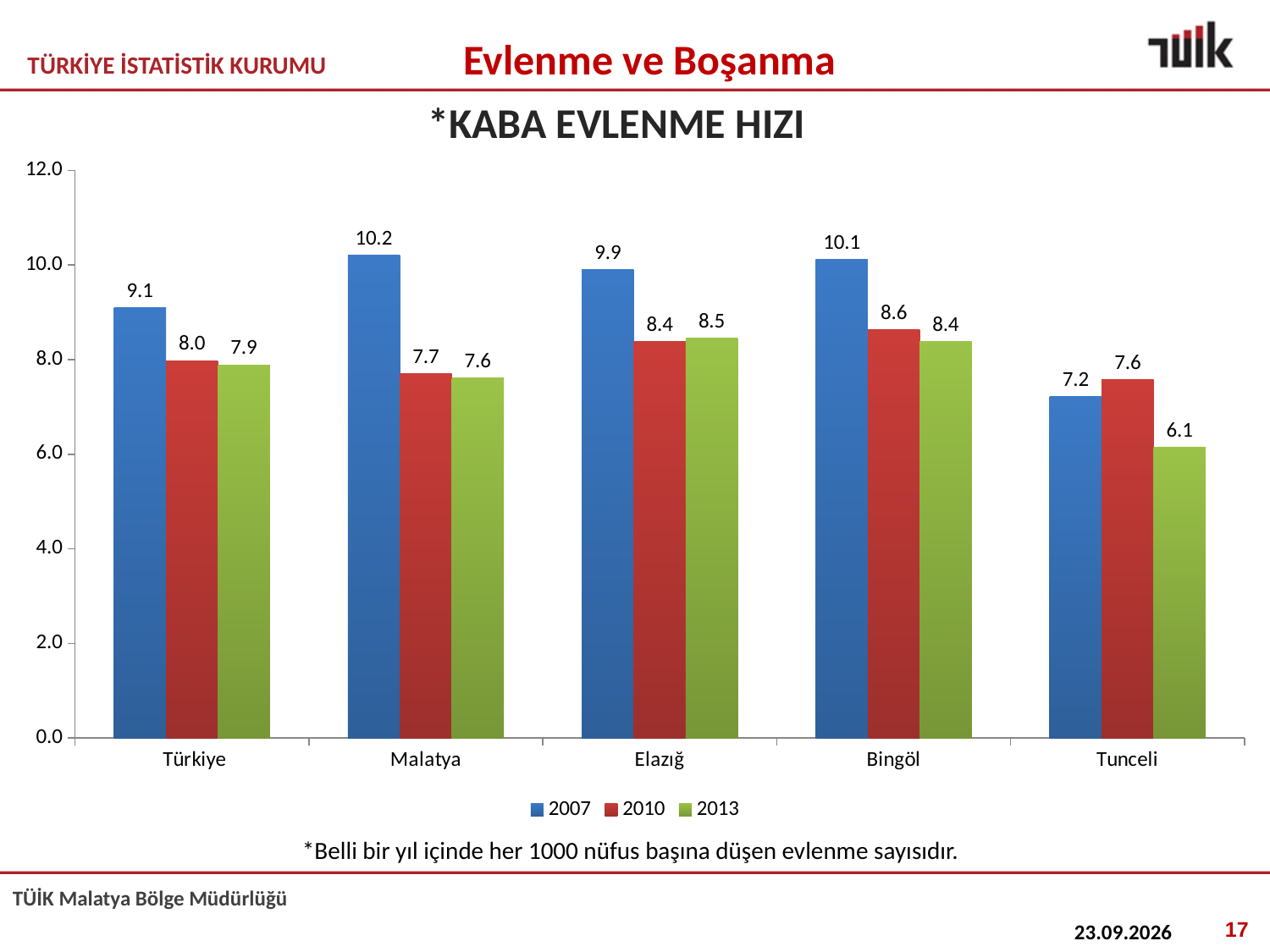
Do the values for Tunceli rise or fall from 2010 to 2013? Fall Which category has the lowest value in the 2013 series? Tunceli What is the value for Bingöl in 2010? 8.6 Which is larger for Tunceli: the 2007 value or the 2010 value? 2010 What is the value for Tunceli in 2013? 6.1 How many categories are shown on the x axis? 5 How many series does the legend list? 3 What is the difference between the 2007 and 2013 values for Malatya? 2.6 What is the crude marriage rate for Malatya in 2007? 10.2 Which category has the highest value in the 2007 series? Malatya What is the title of the chart? *KABA EVLENME HIZI What kind of chart is shown on the slide? Bar chart